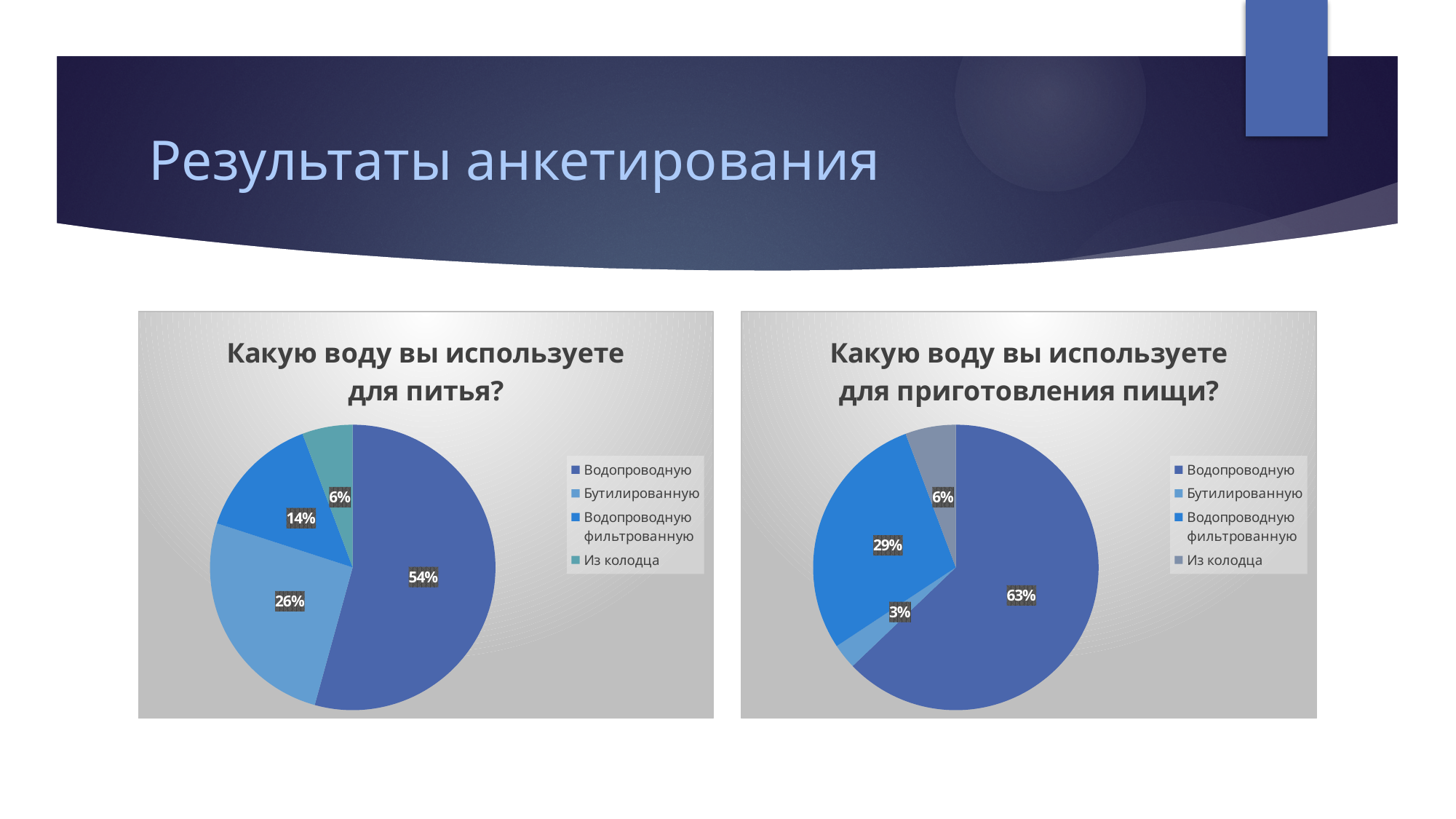
In the chart titled "Какую воду вы используете для питья?", what share is labelled for Водопроводную? 54% How many categories does the legend of the chart titled "Какую воду вы используете для питья?" list? 4 In the chart titled "Какую воду вы используете для приготовления пищи?", what share is labelled for Бутилированную? 3% In the chart titled "Какую воду вы используете для приготовления пищи?", what share is labelled for Водопроводную фильтрованную? 29% What type of chart is the chart on the right of the slide? Pie chart In the chart titled "Какую воду вы используете для питья?", what share is labelled for Бутилированную? 26% In the chart titled "Какую воду вы используете для приготовления пищи?", which category has the smallest slice? Бутилированную In the chart titled "Какую воду вы используете для питья?", what share is labelled for Из колодца? 6% Which is larger in the chart titled "Какую воду вы используете для приготовления пищи?": the share for Водопроводную фильтрованную or the share for Из колодца? Водопроводную фильтрованную In the chart titled "Какую воду вы используете для приготовления пищи?", which category has the largest slice? Водопроводную In the chart titled "Какую воду вы используете для питья?", which category has the smallest slice? Из колодца In the chart titled "Какую воду вы используете для питья?", what is the difference in percentage points between Водопроводную and Бутилированную? 28